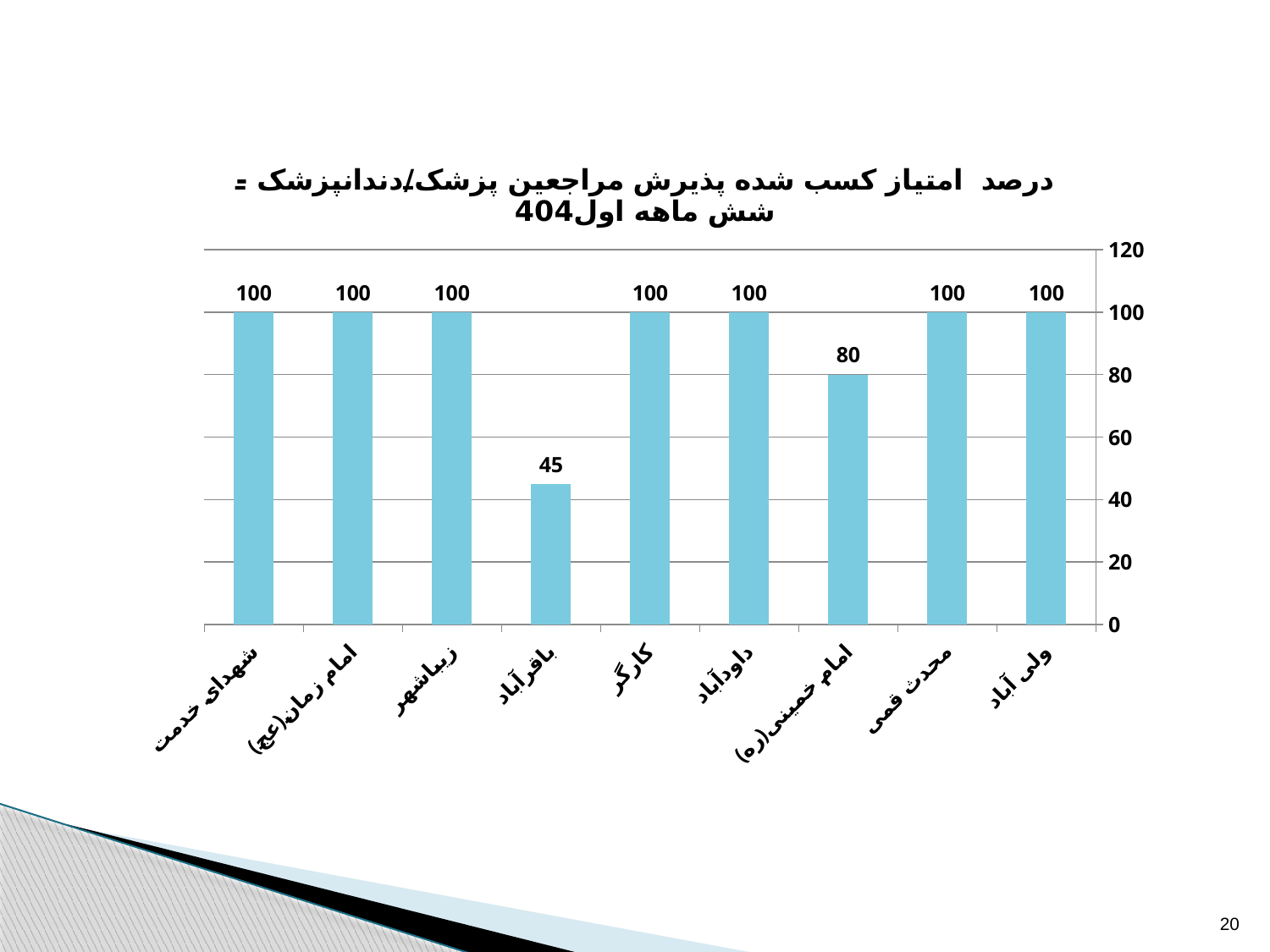
How many categories have a value of 100? 7 Which is larger, the value for داودآباد or the value for باقرآباد? داودآباد What is the difference between the values for کارگر and امام خمینی(ره)? 20 Is the value for امام خمینی(ره) greater or less than 60? greater What is the value for امام خمینی(ره)? 80 How many categories are shown on the x axis? 9 What is the value for باقرآباد? 45 What is the difference between the values for امام خمینی(ره) and باقرآباد? 35 Which category has the lowest value? باقرآباد What is the value for زیباشهر? 100 What is the highest value shown on the vertical axis? 120 What kind of chart is shown on the slide? bar chart